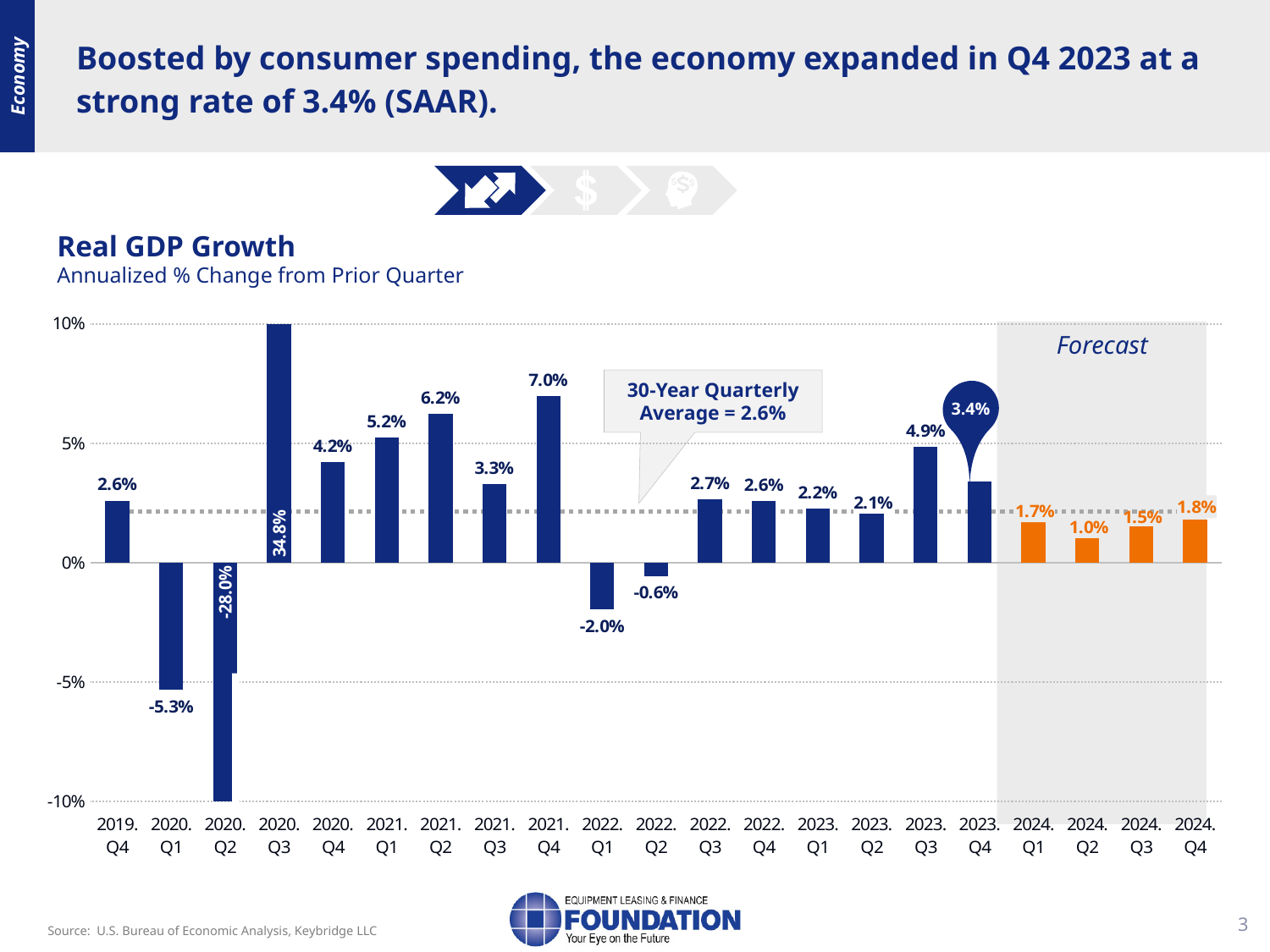
What is the difference between the Real GDP Growth values for 2023 Q3 and 2023 Q4? 1.5% What kind of chart is used to show Real GDP Growth? Bar chart Do the forecast values from 2024 Q1 to 2024 Q4 stay above or below the 30-year quarterly average of 2.6%? Below Which quarter has the highest Real GDP Growth on the chart? 2020 Q3 What is the forecast Real GDP Growth value for 2024 Q2? 1.0% Which quarter has the lowest Real GDP Growth on the chart? 2020 Q2 What is the Real GDP Growth value for 2023 Q4? 3.4% What is the 30-year quarterly average shown on the chart? 2.6% What is the subtitle of the Real GDP Growth chart? Annualized % Change from Prior Quarter Which is larger, the Real GDP Growth value for 2021 Q4 or for 2021 Q2? 2021 Q4 What is the Real GDP Growth value for 2020 Q2? -28.0% How many quarters are plotted on the Real GDP Growth chart? 21